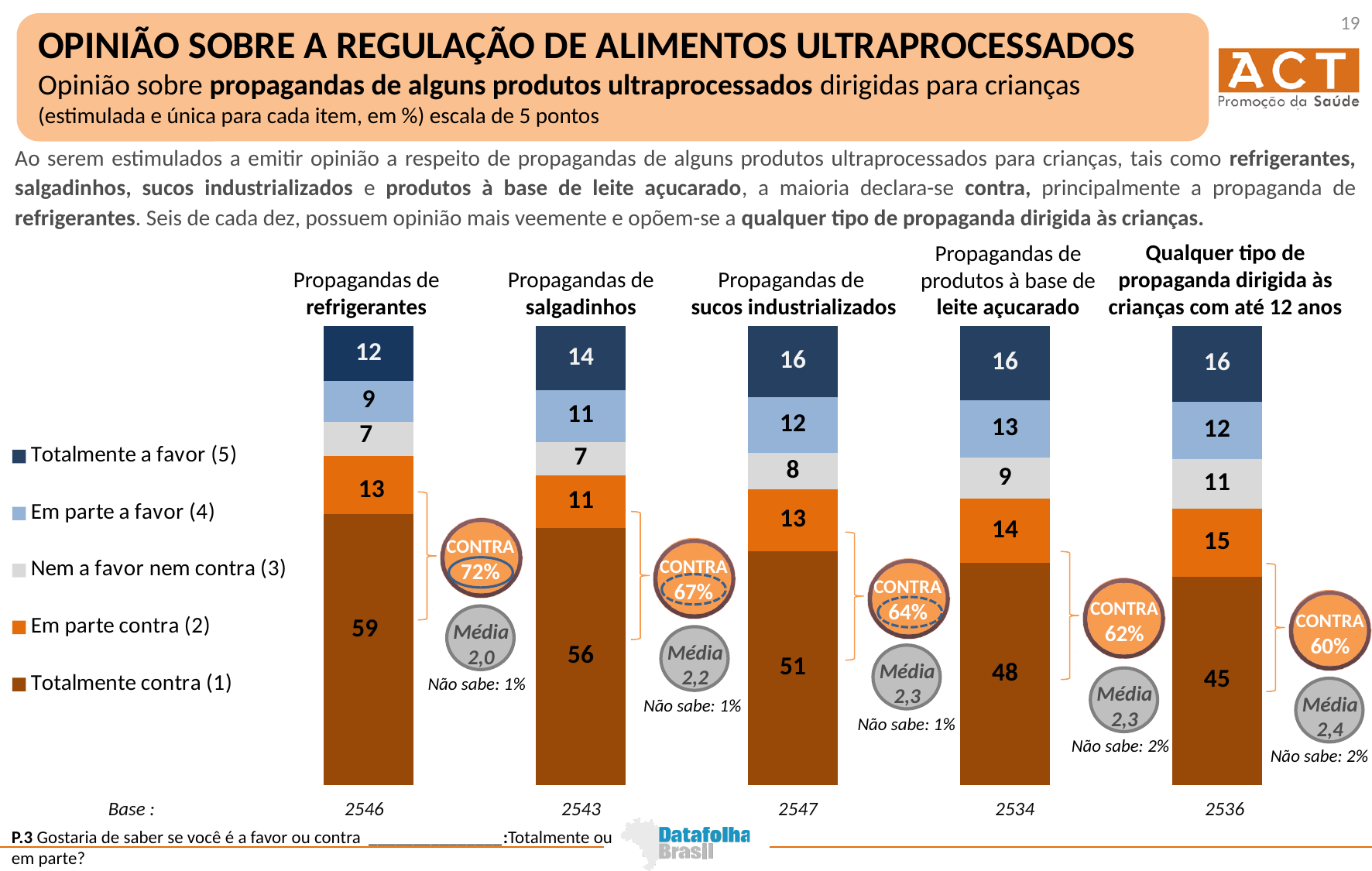
Which category has the lowest value for "Totalmente contra (1)"? Qualquer tipo de propaganda dirigida às crianças com até 12 anos How many series does the legend list? 5 What is the value for "Totalmente contra (1)" for Propagandas de refrigerantes? 59 What is the total of the stacked bar for Propagandas de sucos industrializados? 100 What kind of chart is shown on the slide? Stacked bar chart What is the value for "Em parte contra (2)" for Propagandas de produtos à base de leite açucarado? 14 How many categories (bars) does the chart show? 5 Which is larger: the "Em parte a favor (4)" value for Propagandas de salgadinhos or for Propagandas de produtos à base de leite açucarado? Propagandas de produtos à base de leite açucarado What is the value for "Totalmente a favor (5)" for Propagandas de salgadinhos? 14 Which category has the highest value for "Totalmente contra (1)"? Propagandas de refrigerantes What is the value for "Nem a favor nem contra (3)" for Qualquer tipo de propaganda dirigida às crianças com até 12 anos? 11 What is the difference between the "Totalmente contra (1)" values for Propagandas de refrigerantes and Propagandas de sucos industrializados? 8